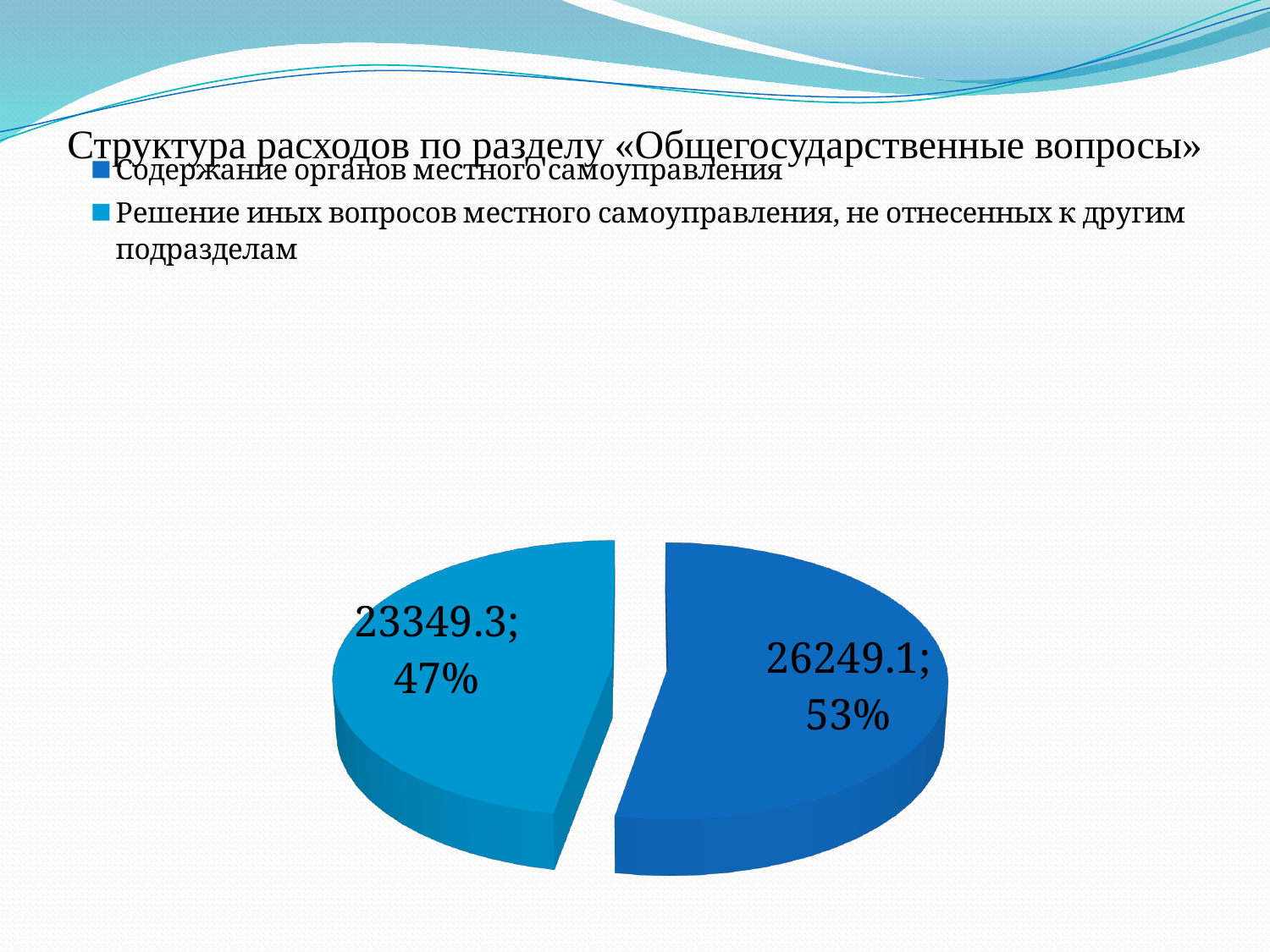
Which slice is the smallest in the pie chart? Решение иных вопросов местного самоуправления, не отнесенных к другим подразделам Which slice is the largest in the pie chart? Содержание органов местного самоуправления What share of the pie does "Решение иных вопросов местного самоуправления, не отнесенных к другим подразделам" represent? 47% What kind of chart is shown on the slide? pie chart What is the title of the chart on the slide? Структура расходов по разделу «Общегосударственные вопросы» What value is shown for the slice "Содержание органов местного самоуправления"? 26249.1 What value is shown for the slice "Решение иных вопросов местного самоуправления, не отнесенных к другим подразделам"? 23349.3 How many slices does the pie chart have? 2 How many entries does the legend list? 2 What share of the pie does "Содержание органов местного самоуправления" represent? 53% What is the difference between the values of the two slices (26249.1 and 23349.3)? 2899.8 Which is larger: "Содержание органов местного самоуправления" or "Решение иных вопросов местного самоуправления, не отнесенных к другим подразделам"? Содержание органов местного самоуправления